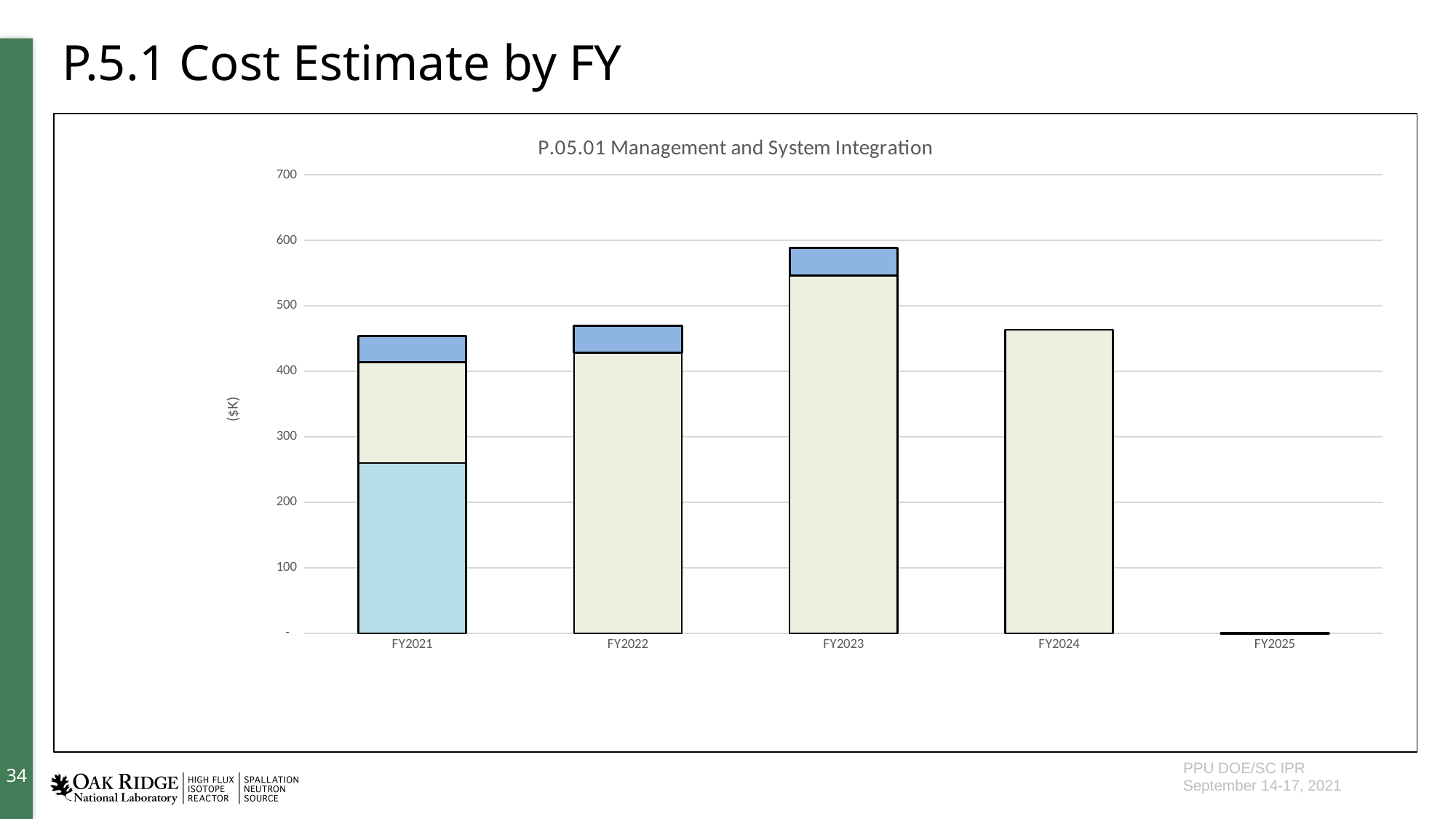
How many fiscal years are shown on the x axis of the chart? 5 What is the label on the vertical axis of the chart? ($K) What is the title of the chart? P.05.01 Management and System Integration Is the total bar for FY2023 greater or less than 500? greater Which has the larger bar, FY2024 or FY2025? FY2024 Which fiscal year has the smallest bar in the chart? FY2025 Which fiscal year has the tallest bar in the chart? FY2023 Is the total bar for FY2021 greater or less than 500? less Is the bar for FY2024 greater or less than 400? greater What kind of chart is shown on the slide? Stacked bar chart Which has the larger total bar, FY2023 or FY2021? FY2023